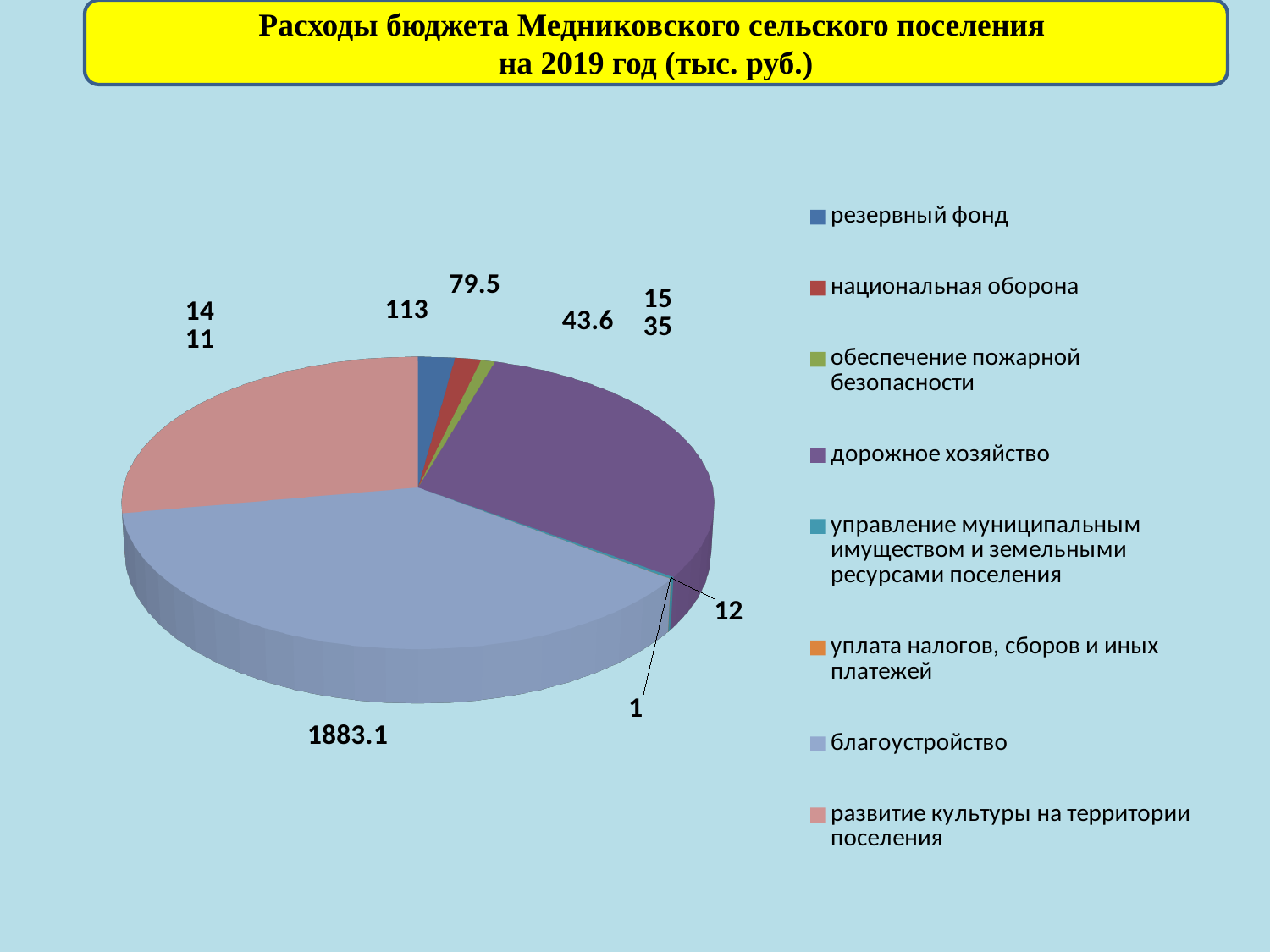
What kind of chart is shown on the slide? pie chart Which slice is larger: дорожное хозяйство or резервный фонд? дорожное хозяйство In what units are the values on the chart given, according to the title? тыс. руб. What is the value labelled on the largest slice of the pie? 1883.1 Which slice is larger: благоустройство or дорожное хозяйство? благоустройство Which slice is larger: развитие культуры на территории поселения or национальная оборона? развитие культуры на территории поселения What is the smallest value printed as a data label on the chart? 1 How many categories does the legend list? 8 Which category has the largest slice of the pie? благоустройство What is the title of the chart on the slide? Расходы бюджета Медниковского сельского поселения на 2019 год (тыс. руб.) What colour is the slice for благоустройство? light blue